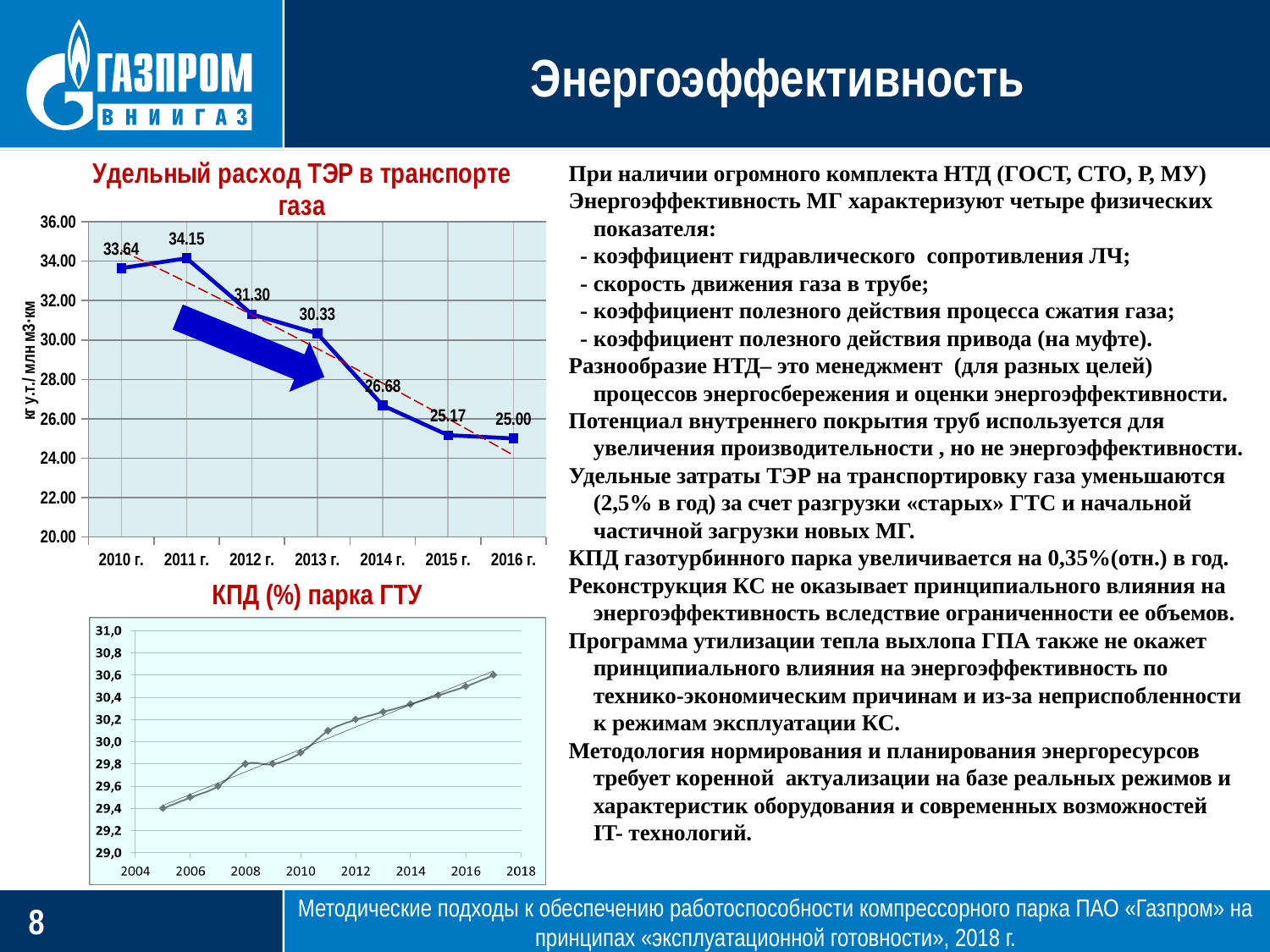
What kind of chart is 'Удельный расход ТЭР в транспорте газа'? line chart In the chart 'Удельный расход ТЭР в транспорте газа', how many years are plotted? 7 In the chart 'КПД (%) парка ГТУ', is the value for 2005 greater or less than 30.0? less In the chart 'Удельный расход ТЭР в транспорте газа', what is the value for 2011 г.? 34.15 In the chart 'Удельный расход ТЭР в транспорте газа', what is the difference between the values for 2010 г. and 2016 г.? 8.64 In the chart 'Удельный расход ТЭР в транспорте газа', which year has the highest value? 2011 г. In the chart 'Удельный расход ТЭР в транспорте газа', do the values generally rise or fall from 2010 г. to 2016 г.? fall In the chart 'КПД (%) парка ГТУ', is the value for 2017 greater or less than 30.0? greater In the chart 'Удельный расход ТЭР в транспорте газа', which year has the lowest value? 2016 г. In the chart 'Удельный расход ТЭР в транспорте газа', what is the value for 2014 г.? 26.68 In the chart 'КПД (%) парка ГТУ', do the values rise or fall over the years shown? rise In the chart 'Удельный расход ТЭР в транспорте газа', which is larger: the value for 2012 г. or the value for 2013 г.? 2012 г.